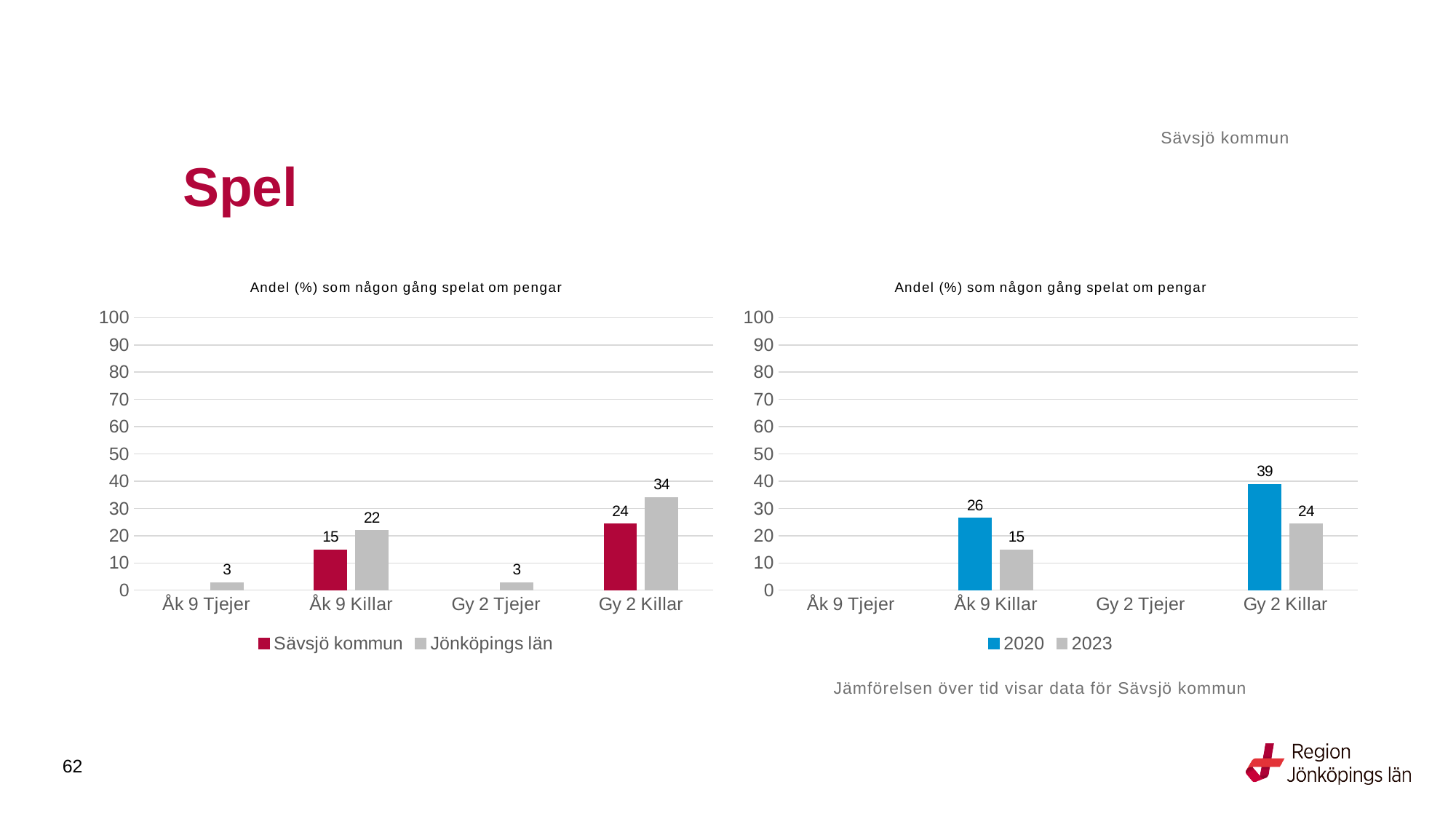
What kind of chart is the right chart? Bar chart In the right chart, what is the value for 2020 for Gy 2 Killar? 39 In the left chart, how many series does the legend list? 2 In the left chart, what is the value for Jönköpings län for Åk 9 Tjejer? 3 In the left chart, what is the value for Jönköpings län for Gy 2 Killar? 34 In the right chart, which is larger for Åk 9 Killar, 2020 or 2023? 2020 In the right chart, what is the value for 2023 for Åk 9 Killar? 15 In the right chart, what is the difference between 2020 and 2023 for Gy 2 Killar? 15 In the right chart, how many categories are shown on the x axis? 4 In the left chart, which category has the highest value for Jönköpings län? Gy 2 Killar In the left chart, what is the value for Sävsjö kommun for Åk 9 Killar? 15 In the left chart, what is the difference between Jönköpings län and Sävsjö kommun for Gy 2 Killar? 10